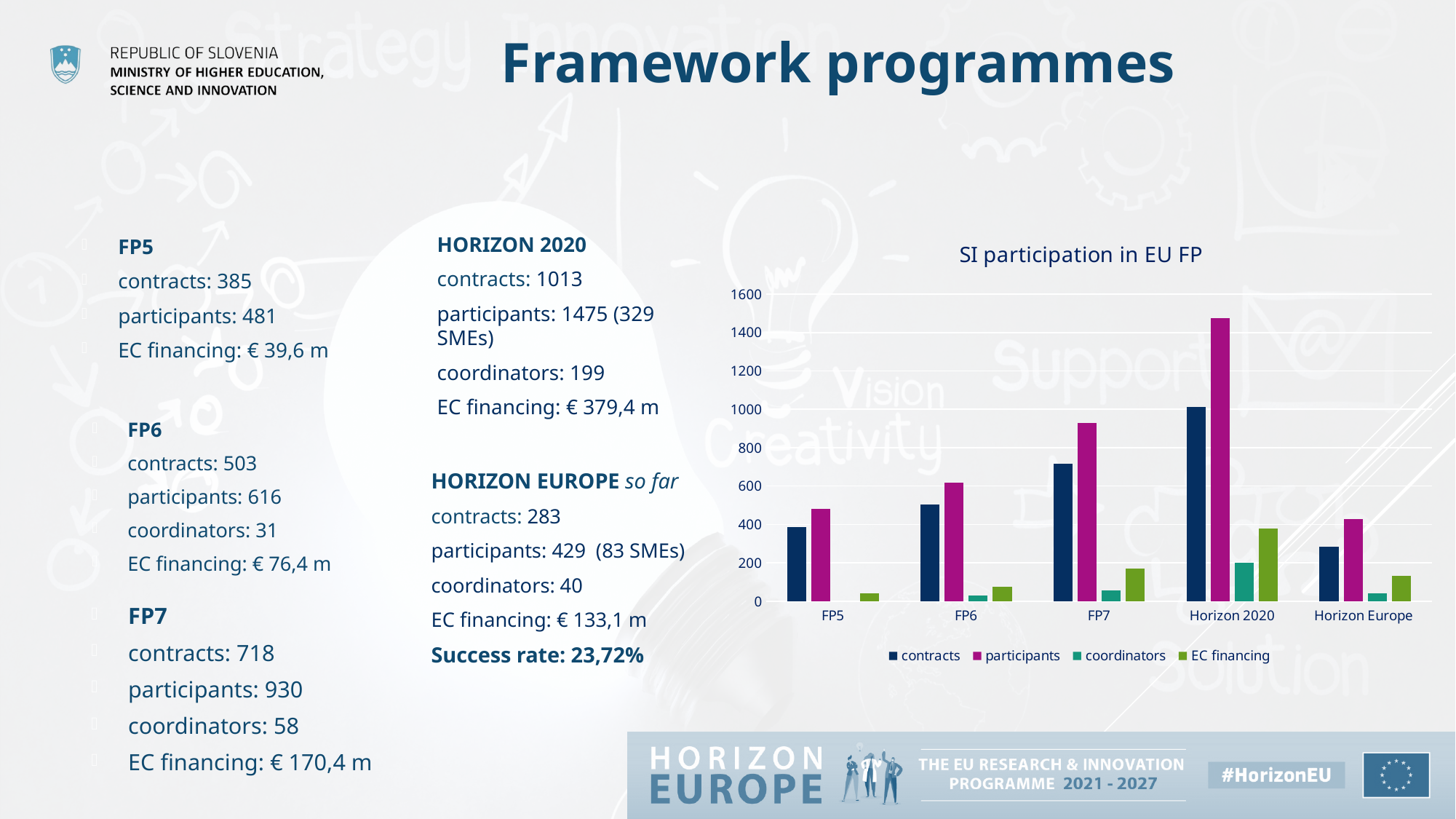
Which programme has the highest participants bar in the chart? Horizon 2020 Do the contracts values rise or fall from FP5 to Horizon 2020? rise Which is larger, the participants value for FP6 or for FP7? FP7 What is the title of the chart? SI participation in EU FP How many framework programmes are shown along the x axis of the chart? 5 What is the contracts value for Horizon 2020? 1013 Is the participants value for Horizon 2020 greater or less than 1400? greater Is the contracts value for FP7 greater or less than 600? greater What colour are the participants bars in the chart? magenta Which programme has the lowest contracts bar in the chart? Horizon Europe How many series does the legend of the chart list? 4 What kind of chart is shown on the slide? bar chart